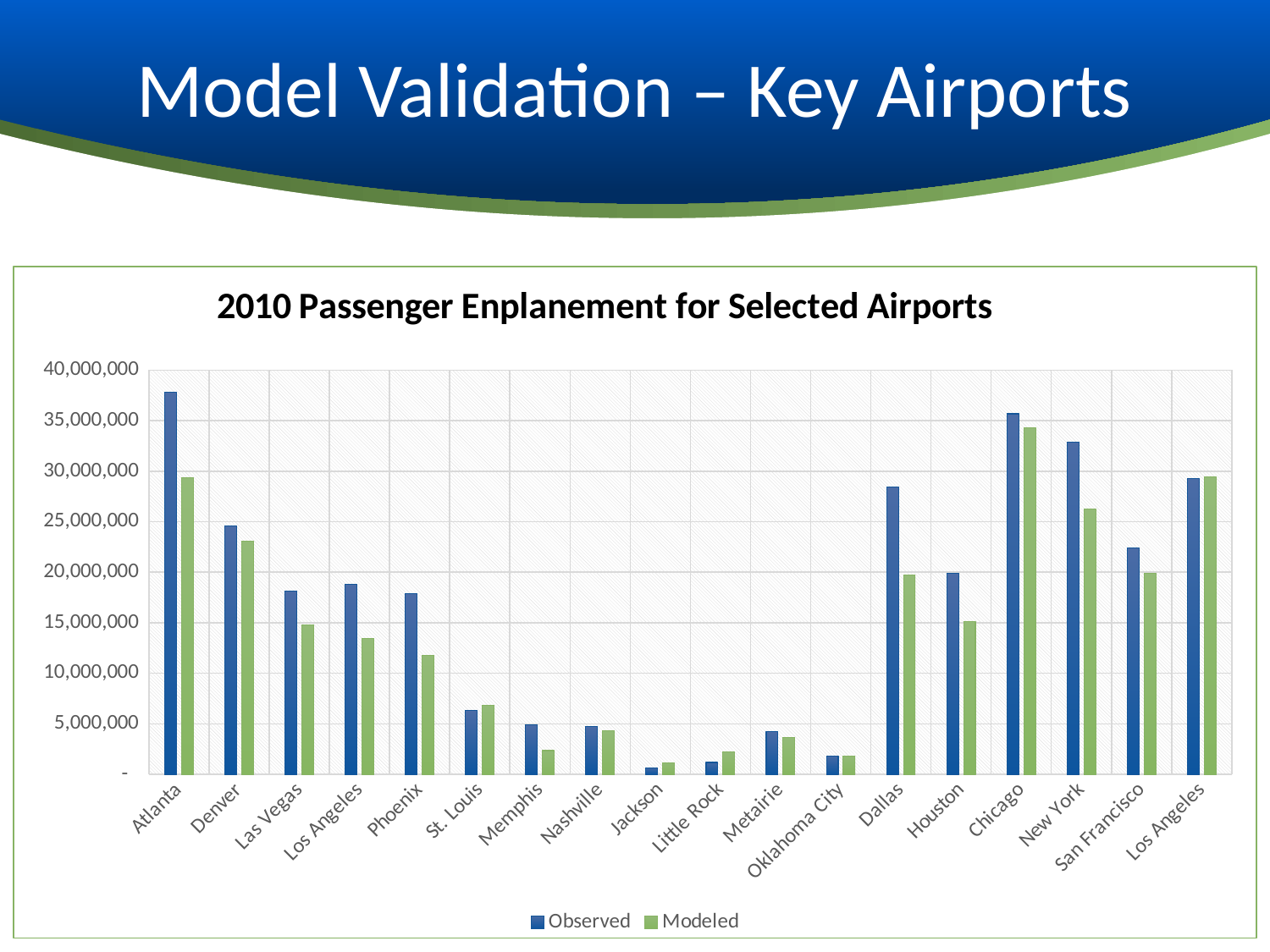
Is the Observed value for Dallas greater or less than 25,000,000? greater How many airport categories are shown on the x axis? 18 Which airport has the lowest Observed value? Jackson Which has the larger Observed value, Denver or Las Vegas? Denver Is the Observed value for Atlanta greater or less than 35,000,000? greater What type of chart is shown on the slide? Bar chart Which airport has the highest Observed value? Atlanta Which airport has the highest Modeled value? Chicago Is the Modeled value for Houston greater or less than 20,000,000? less For Little Rock, which is larger, the Observed or the Modeled value? Modeled How many series does the legend list? 2 What is the title of the chart? 2010 Passenger Enplanement for Selected Airports